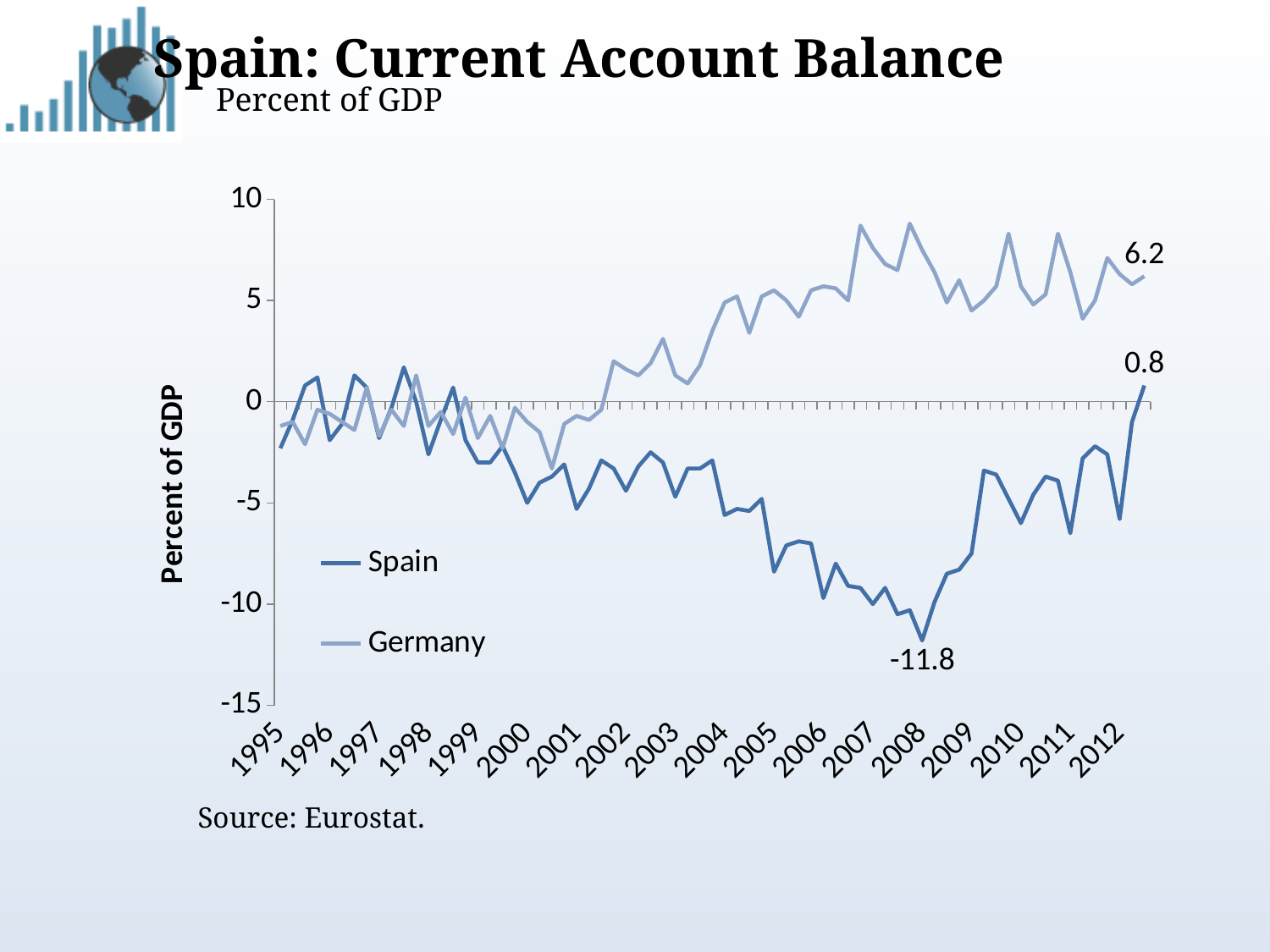
Is the peak value for Germany around 2007 greater or less than 5? greater What is the lowest labelled value reached by Spain? -11.8 How many series does the legend list? 2 Does the Spain line generally rise or fall between 2004 and 2008? fall What kind of chart is shown on the slide? line chart Is the lowest value for Spain around 2008 greater or less than -10? less What is the last labelled value for Germany at the end of the series? 6.2 What is the label on the vertical axis? Percent of GDP At the end of the series, which is larger: the value for Germany or the value for Spain? Germany What is the last labelled value for Spain at the end of the series? 0.8 Which series reaches the lowest value on the chart? Spain What is the difference between the final labelled values for Germany (6.2) and Spain (0.8)? 5.4